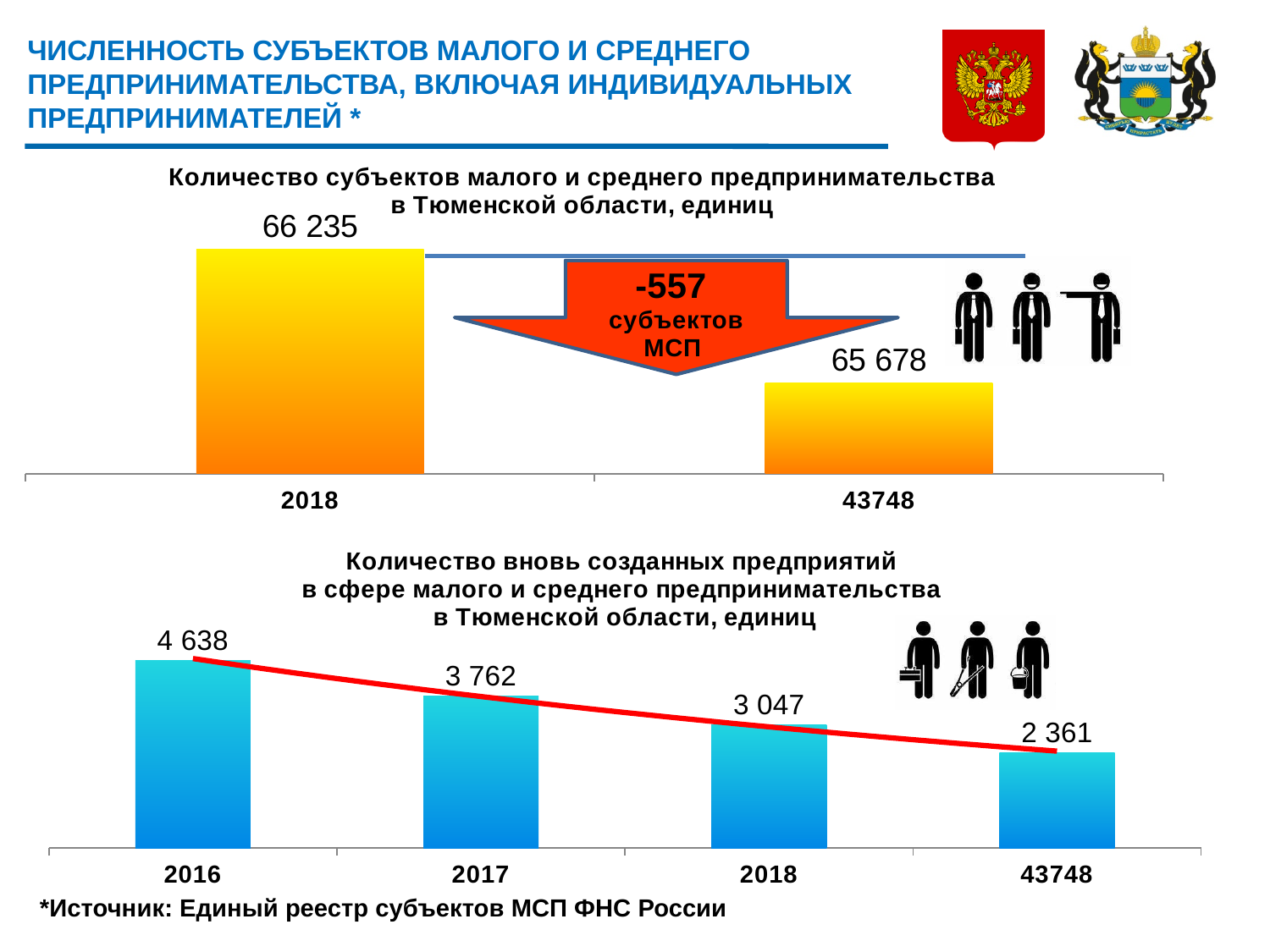
In the bottom chart, what is the difference between the 2016 and 2017 values? 876 In the bottom chart, which category has the lowest value? 43748 In the top chart, how many bars are plotted? 2 In the top chart, which category has the higher value, 2018 or 43748? 2018 In the bottom chart, do the values rise or fall from left to right along the x axis? fall In the bottom chart, what is the value for 2016? 4 638 In the top chart, what is the value for 2018? 66 235 In the bottom chart, what is the value for 2018? 3 047 In the bottom chart, what is the value for 2017? 3 762 In the top chart, what is the difference between the 2018 value and the value for the category labelled 43748? 557 What kind of chart is the bottom chart? bar chart In the top chart, what is the value for the category labelled 43748? 65 678